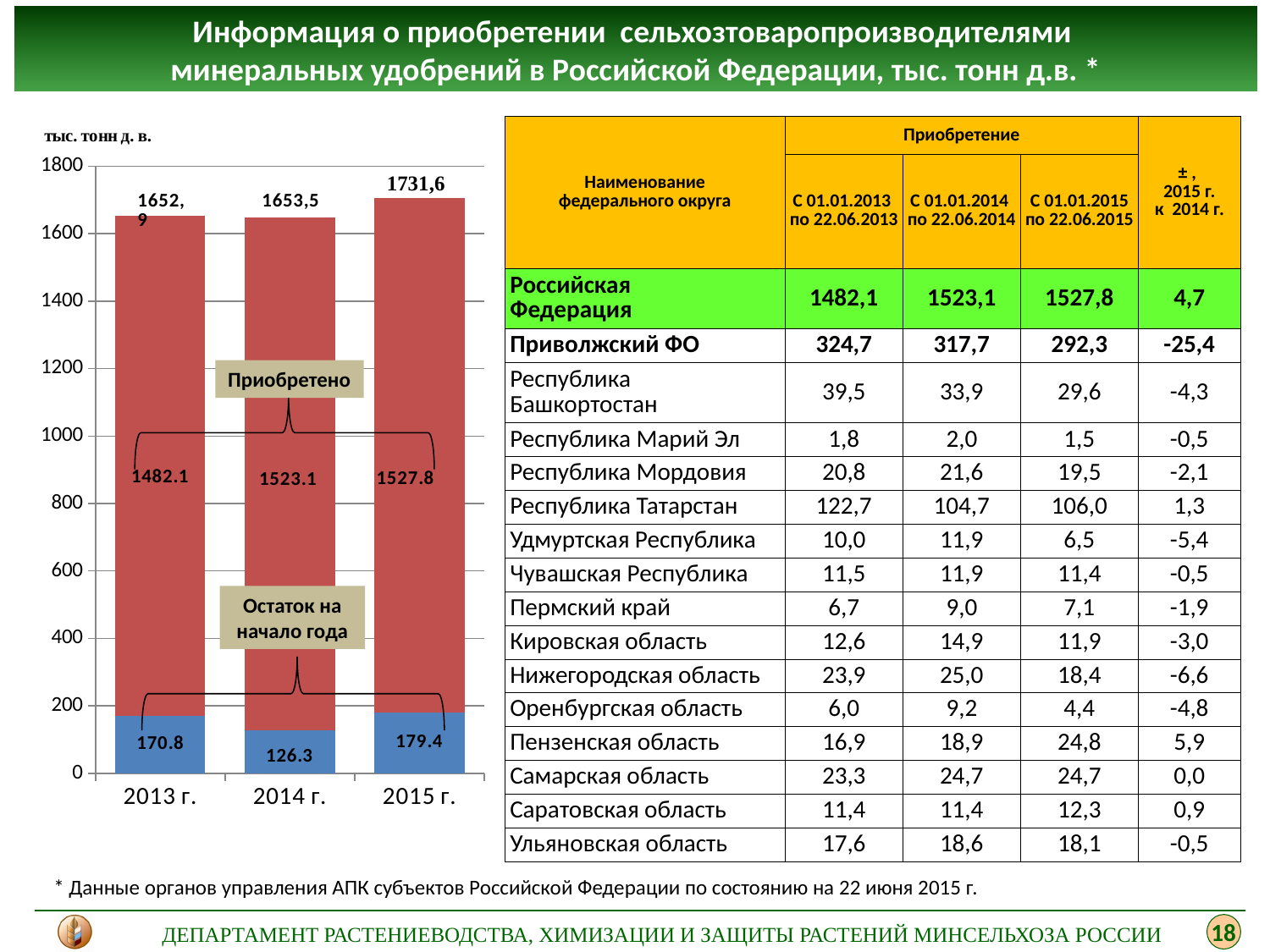
In the bar chart, is the "Приобретено" value for 2013 г. larger or smaller than that for 2014 г.? smaller In the bar chart, which colour represents "Остаток на начало года"? blue In the bar chart, which year has the lowest value of "Остаток на начало года"? 2014 г. How many years are shown on the x axis of the bar chart? 3 In the bar chart, what is the difference between the "Остаток на начало года" values for 2015 г. and 2014 г.? 53.1 In the bar chart, what is the value of "Приобретено" for 2014 г.? 1523.1 In the bar chart, what is the value of "Остаток на начало года" for 2013 г.? 170.8 In the bar chart, what is the total shown above the bar for 2015 г.? 1731,6 In the bar chart, what is the value of "Остаток на начало года" for 2015 г.? 179.4 What kind of chart is shown on the left of the slide? stacked bar chart In the bar chart, which year has the highest value of "Приобретено"? 2015 г. Does the "Приобретено" value rise or fall from 2013 г. to 2015 г. in the bar chart? rise